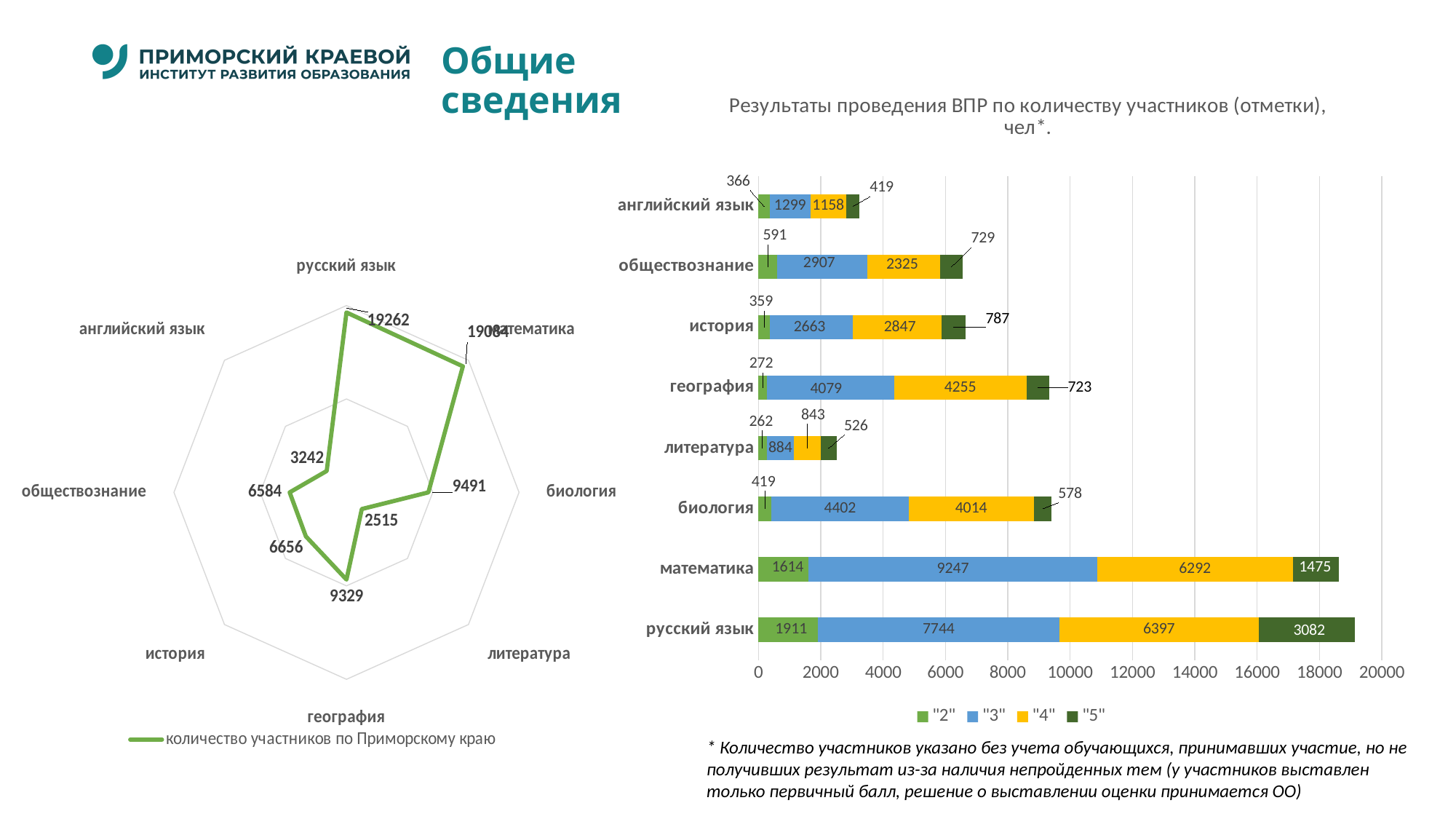
In the stacked bar chart on the right, which subject has the longest bar overall? русский язык In the radar chart on the left, what is the number of participants for литература? 2515 In the stacked bar chart on the right, how many participants received a "5" in русский язык? 3082 In the stacked bar chart on the right, how many participants received a "3" in математика? 9247 In the radar chart on the left, how many subjects are plotted? 8 In the stacked bar chart on the right, how many participants received a "2" in география? 272 In the stacked bar chart on the right, is the number of "3" grades in биология larger than the number of "3" grades in география? Yes, 4402 vs 4079 In the radar chart on the left, what is the number of participants for русский язык? 19262 In the stacked bar chart on the right, which subject has the shortest bar overall? литература In the stacked bar chart on the right, how many series does the legend list? 4 In the stacked bar chart on the right, what is the total number of participants for английский язык (sum of all four grades)? 3242 In the stacked bar chart on the right, what is the difference between the number of "4" grades in история and in обществознание? 522